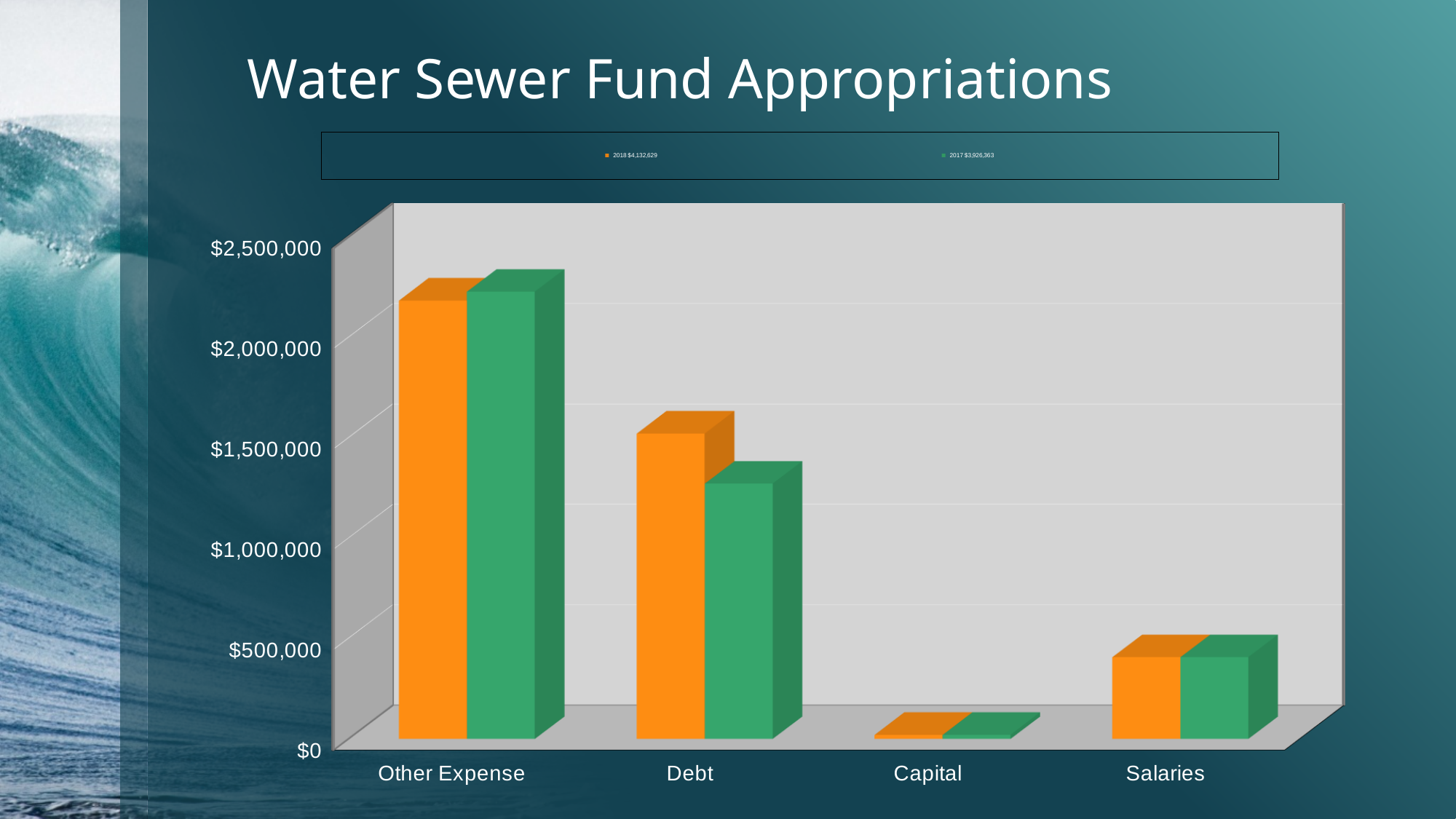
For Debt, which series has the larger value, 2018 or 2017? 2018 Is the 2017 value for Debt greater or less than $1,500,000? less Which category has the highest value for the 2018 series? Other Expense Which category has the lowest value for the 2017 series? Capital What is the title of the chart on the slide? Water Sewer Fund Appropriations Is the 2018 value for Debt greater or less than $1,000,000? greater Is the 2017 value for Salaries greater or less than $500,000? less How many categories are shown on the x axis of the chart? 4 What kind of chart is shown on the slide? Bar chart Which colour represents the 2017 series in the chart? Green How many series does the chart's legend list? 2